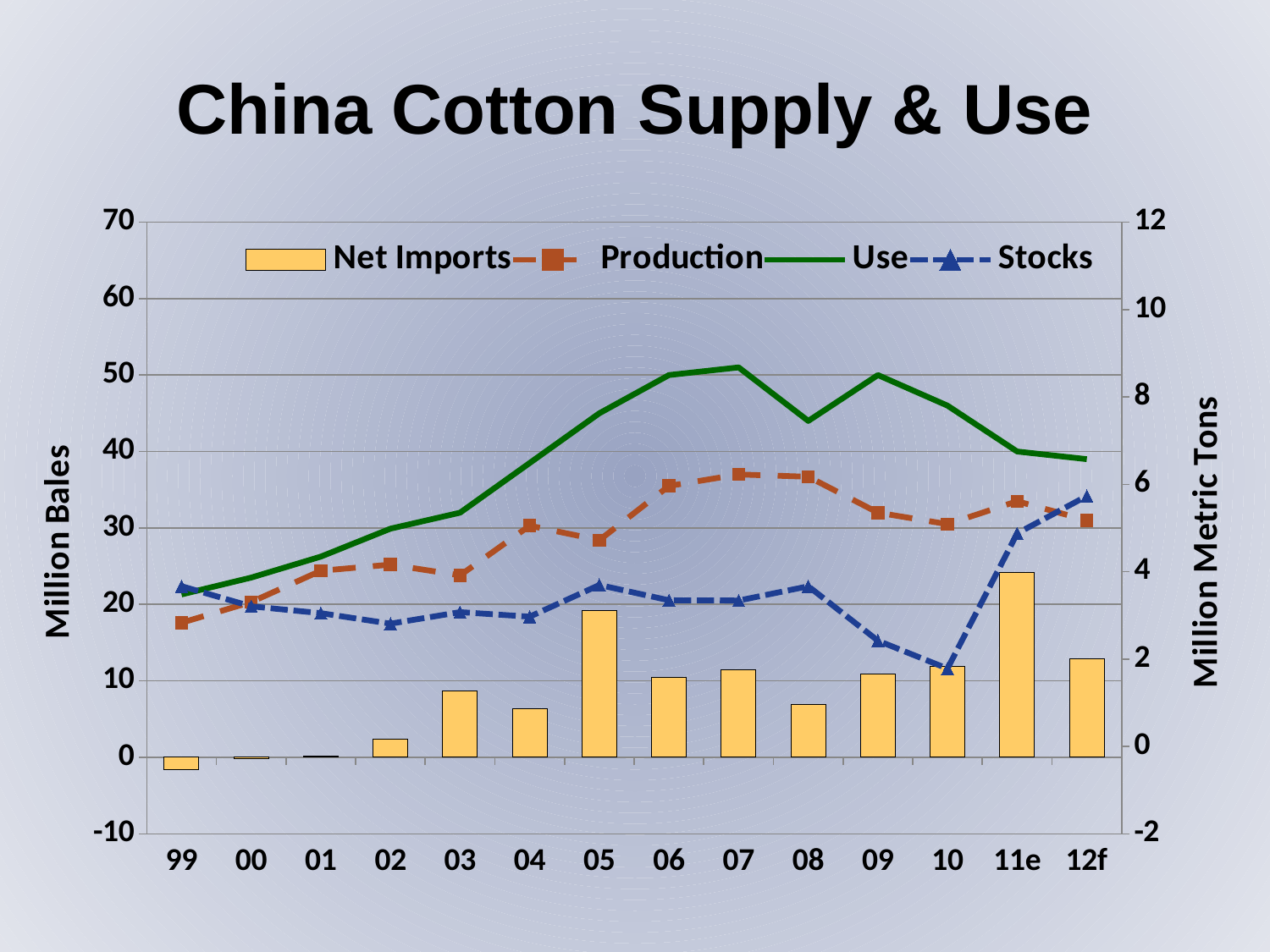
Does Use rise or fall from 99 to 07? Rise In which year are Stocks lowest? 10 Is the value for Stocks in 10 greater or less than 20 million bales? less What is the label on the left vertical axis? Million Bales In which year are Net Imports lowest? 99 What kind of chart is shown on the slide? A combination bar and line chart Is the value for Net Imports in 05 greater or less than 10 million bales? greater Is the value for Use in 08 greater or less than 50 million bales? less In which year are Net Imports highest? 11e How many series does the legend list? 4 How many years are shown along the x axis? 14 In 07, which is larger, Use or Production? Use